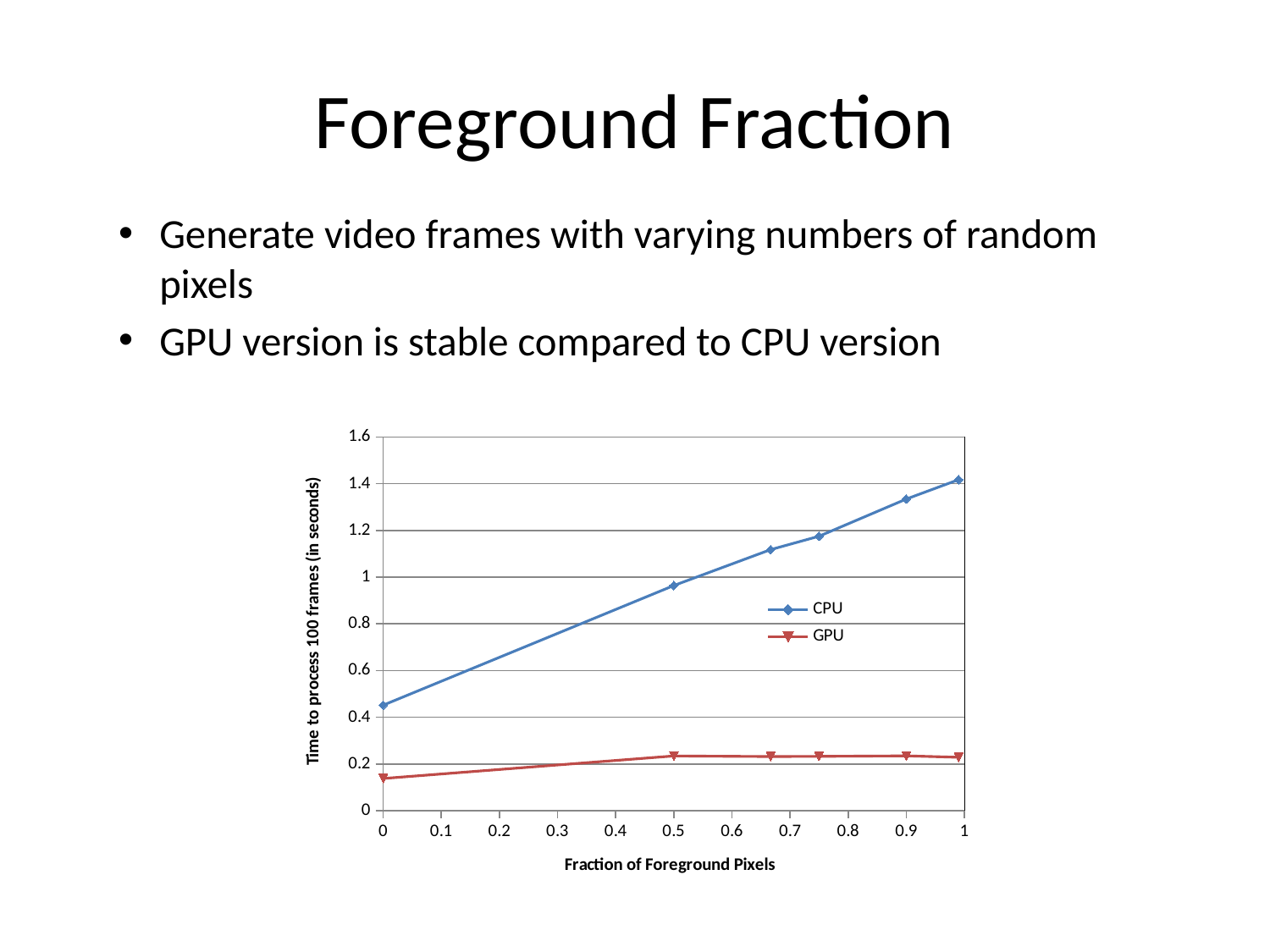
What kind of chart is shown on the slide? line chart Which series has the lowest values across the chart? GPU Does the CPU line rise or fall as the fraction of foreground pixels increases? rise Is the CPU value at a fraction of 0 greater or less than 0.6? less Is the GPU value at a fraction of 0.5 greater or less than 0.4? less Is the CPU value at a fraction of 0.5 greater or less than 0.8? greater At a fraction of 0.5, which series has the larger value, CPU or GPU? CPU What are the two series named in the legend? CPU and GPU What is the title of the x axis? Fraction of Foreground Pixels Which series reaches the highest value on the chart? CPU How many series does the legend list? 2